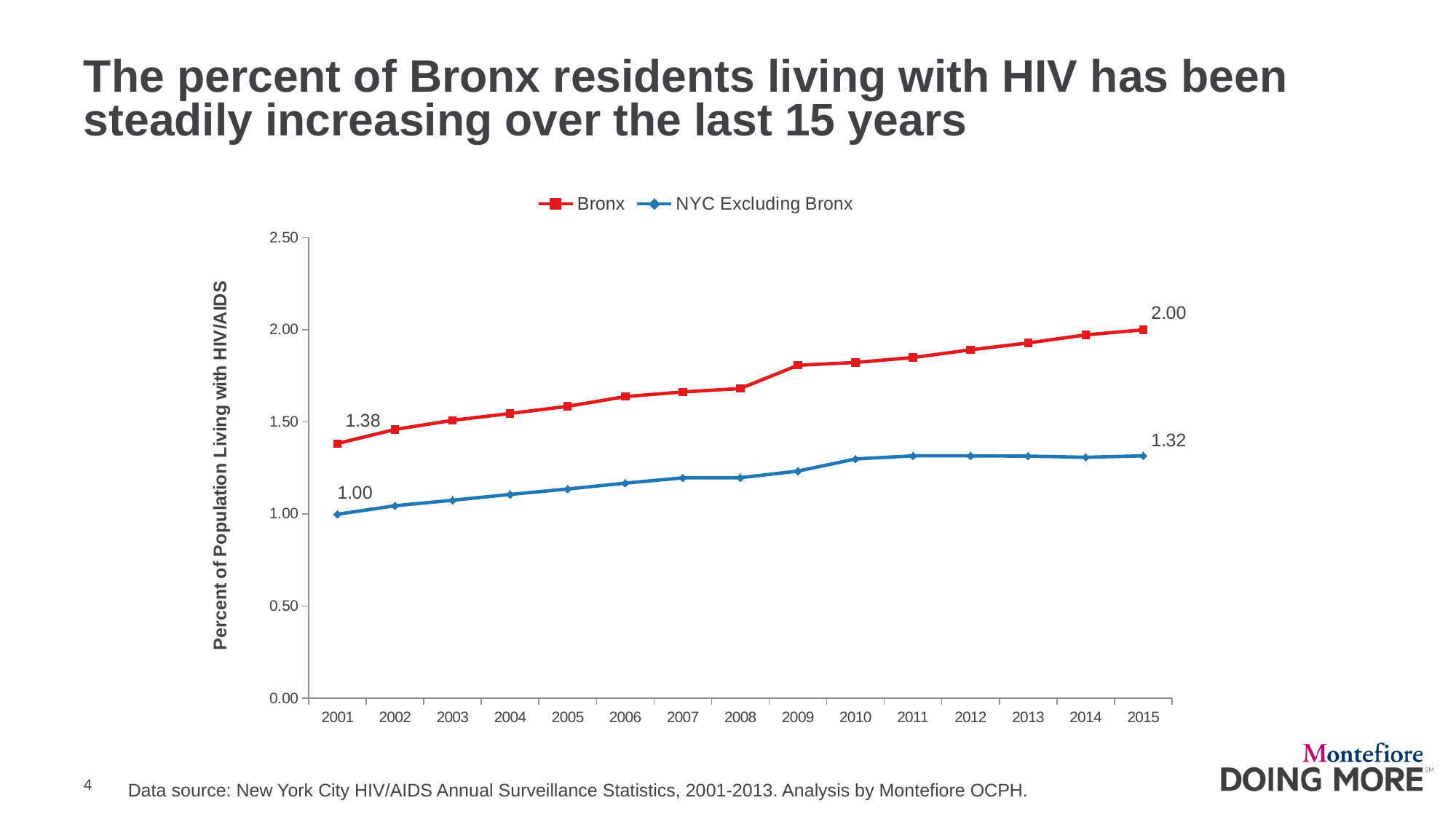
What is the value for NYC Excluding Bronx in 2015? 1.32 What is the value for Bronx in 2015? 2.00 What is the value for NYC Excluding Bronx in 2001? 1.00 Which series has the higher value in 2010, Bronx or NYC Excluding Bronx? Bronx Is the value for NYC Excluding Bronx in 2005 greater or less than 1.50? less What is the difference between the Bronx value in 2015 and the Bronx value in 2001? 0.62 How many years are shown on the x axis? 15 What kind of chart is shown on the slide? Line chart Is the value for Bronx in 2009 greater or less than 1.50? greater What is the difference between the Bronx and NYC Excluding Bronx values in 2015? 0.68 How many series does the legend list? 2 What is the value for Bronx in 2001? 1.38